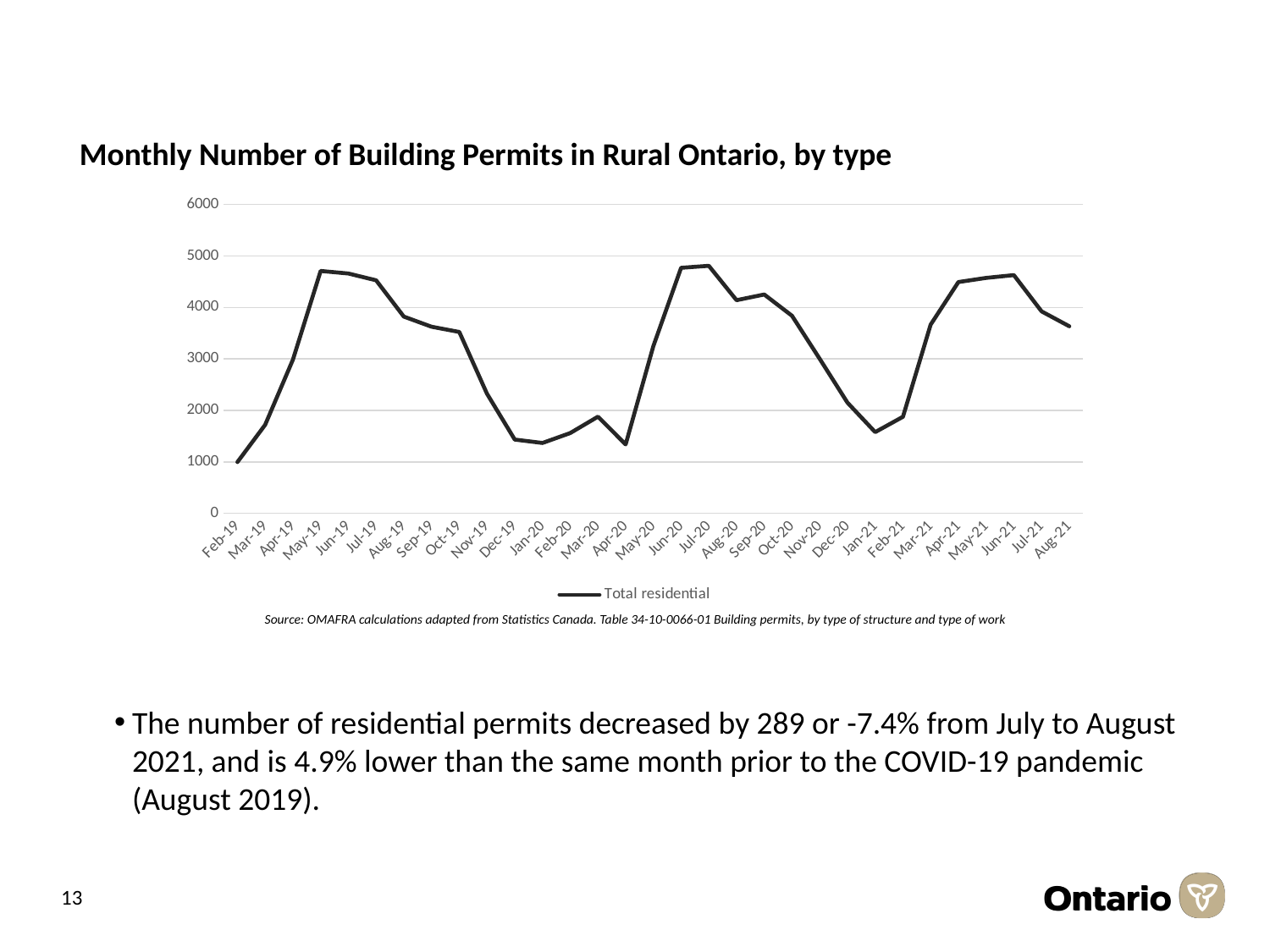
Is the value for Dec-19 greater or less than 2000? less Is the value for Aug-21 greater or less than 4000? less What kind of chart is shown on the slide? Line chart How many series does the legend list? 1 Which is larger, the value for Mar-21 or the value for Dec-20? Mar-21 Is the value for Jul-20 greater or less than 4000? greater Which is larger, the value for Jul-20 or the value for Apr-20? Jul-20 What is the title of the chart? Monthly Number of Building Permits in Rural Ontario, by type What is the name of the series shown in the legend? Total residential How many months are plotted along the x axis? 31 Which month has the lowest value for Total residential? Feb-19 Do the values rise or fall from Feb-19 to May-19? Rise